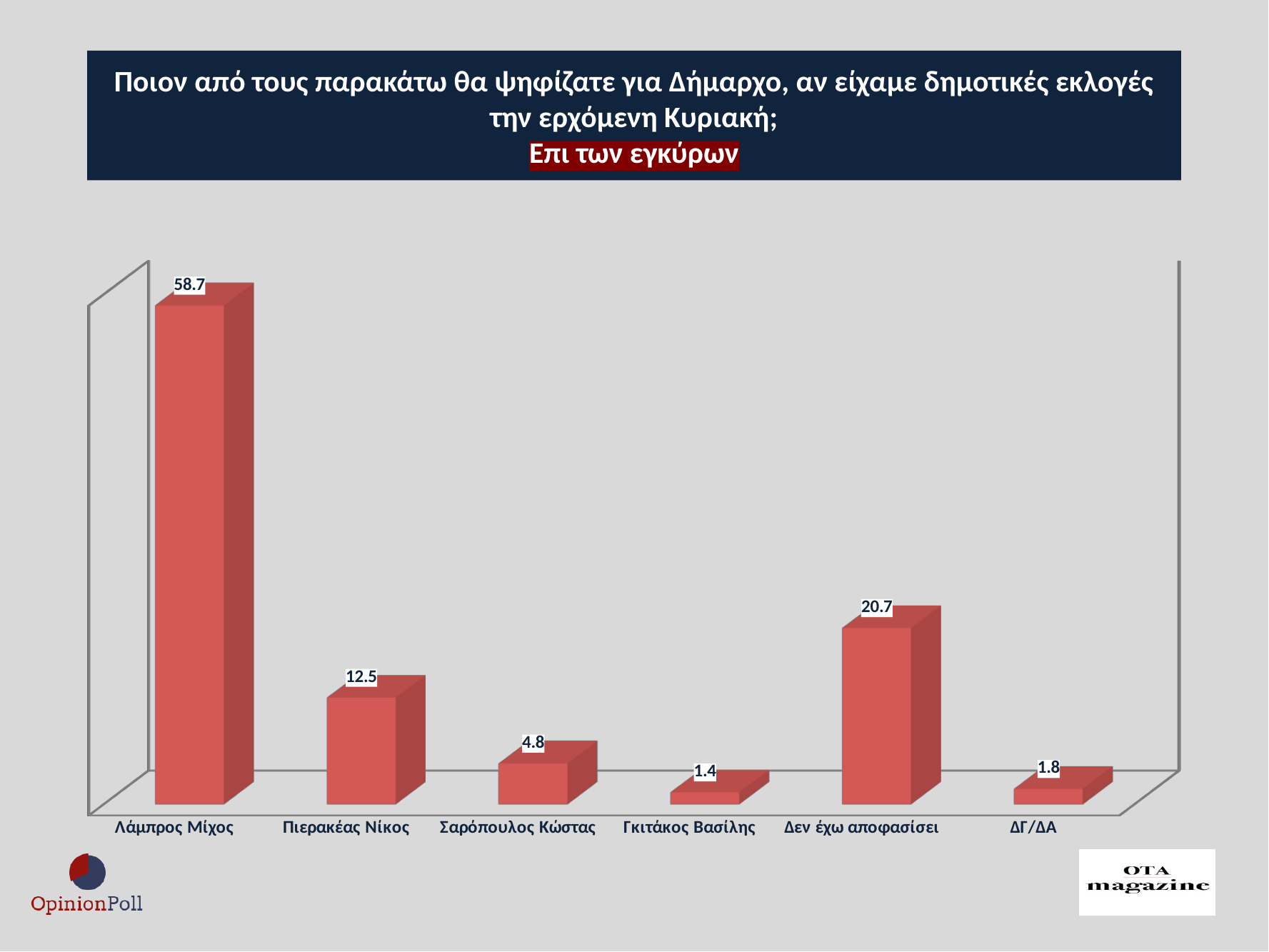
Which category has the lowest value? Γκιτάκος Βασίλης What is the difference between the values for Πιερακέας Νίκος and Σαρόπουλος Κώστας? 7.7 What colour are the bars in the chart? Red What is the value for Πιερακέας Νίκος? 12.5 What is the value for Λάμπρος Μίχος? 58.7 Which is larger, the value for Πιερακέας Νίκος or the value for Δεν έχω αποφασίσει? Δεν έχω αποφασίσει What is the value for ΔΓ/ΔΑ? 1.8 What is the value for Δεν έχω αποφασίσει? 20.7 What is the difference between the values for Λάμπρος Μίχος and Δεν έχω αποφασίσει? 38 Which category has the highest value? Λάμπρος Μίχος How many categories are shown on the chart? 6 What kind of chart is shown on the slide? Bar chart